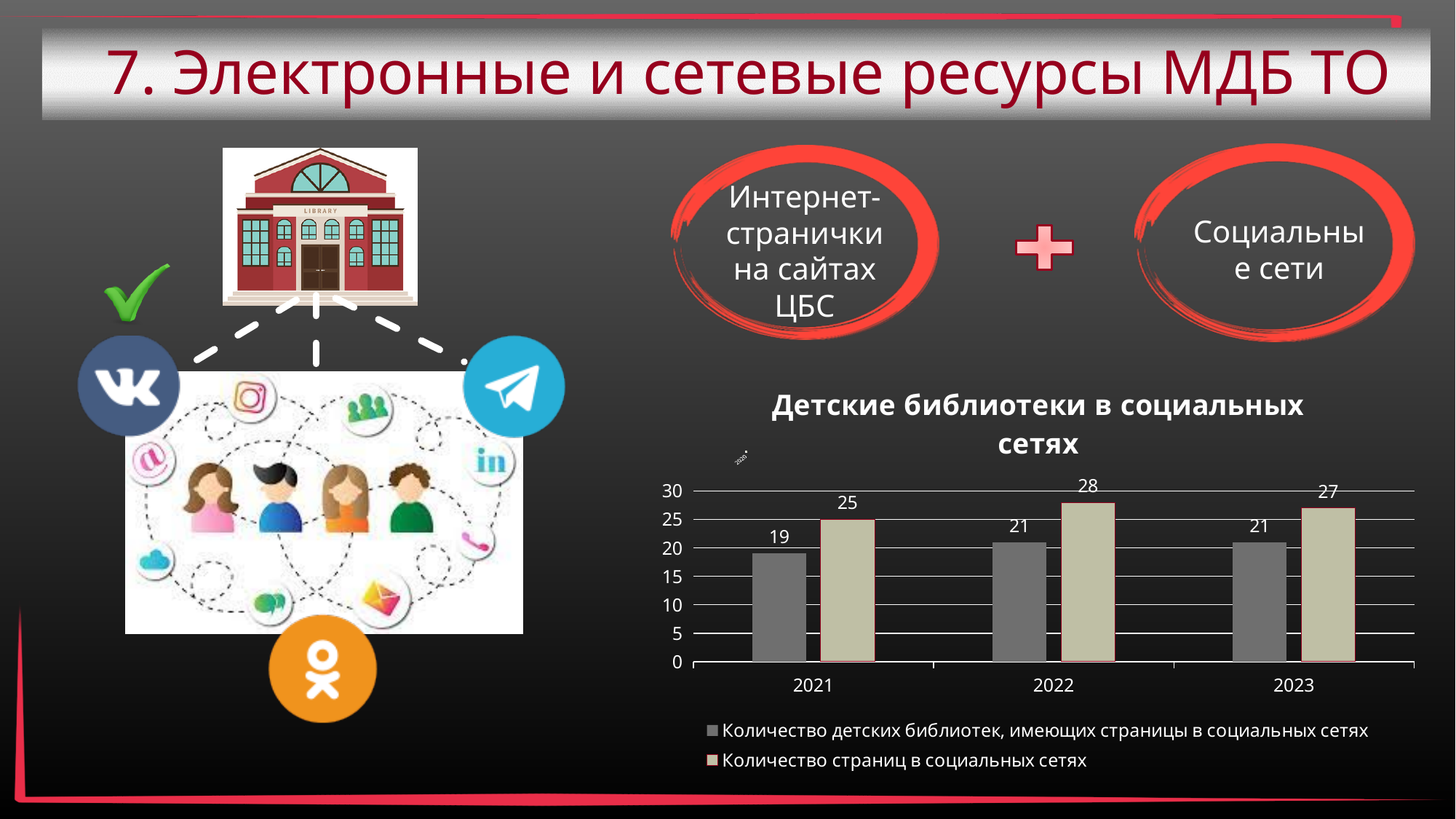
What is the value of 'Количество детских библиотек, имеющих страницы в социальных сетях' in 2021? 19 What is the difference between 'Количество страниц в социальных сетях' and 'Количество детских библиотек, имеющих страницы в социальных сетях' in 2022? 7 What is the title of the chart? Детские библиотеки в социальных сетях What is the value of 'Количество страниц в социальных сетях' in 2023? 27 In which year is 'Количество страниц в социальных сетях' highest? 2022 By how much did 'Количество страниц в социальных сетях' increase from 2021 to 2022? 3 How many series does the chart legend list? 2 What is the value of 'Количество страниц в социальных сетях' in 2022? 28 How many years are shown on the x axis of the chart? 3 Which is larger in 2023: 'Количество детских библиотек, имеющих страницы в социальных сетях' or 'Количество страниц в социальных сетях'? Количество страниц в социальных сетях In which year is 'Количество детских библиотек, имеющих страницы в социальных сетях' lowest? 2021 What type of chart is shown on the slide? bar chart